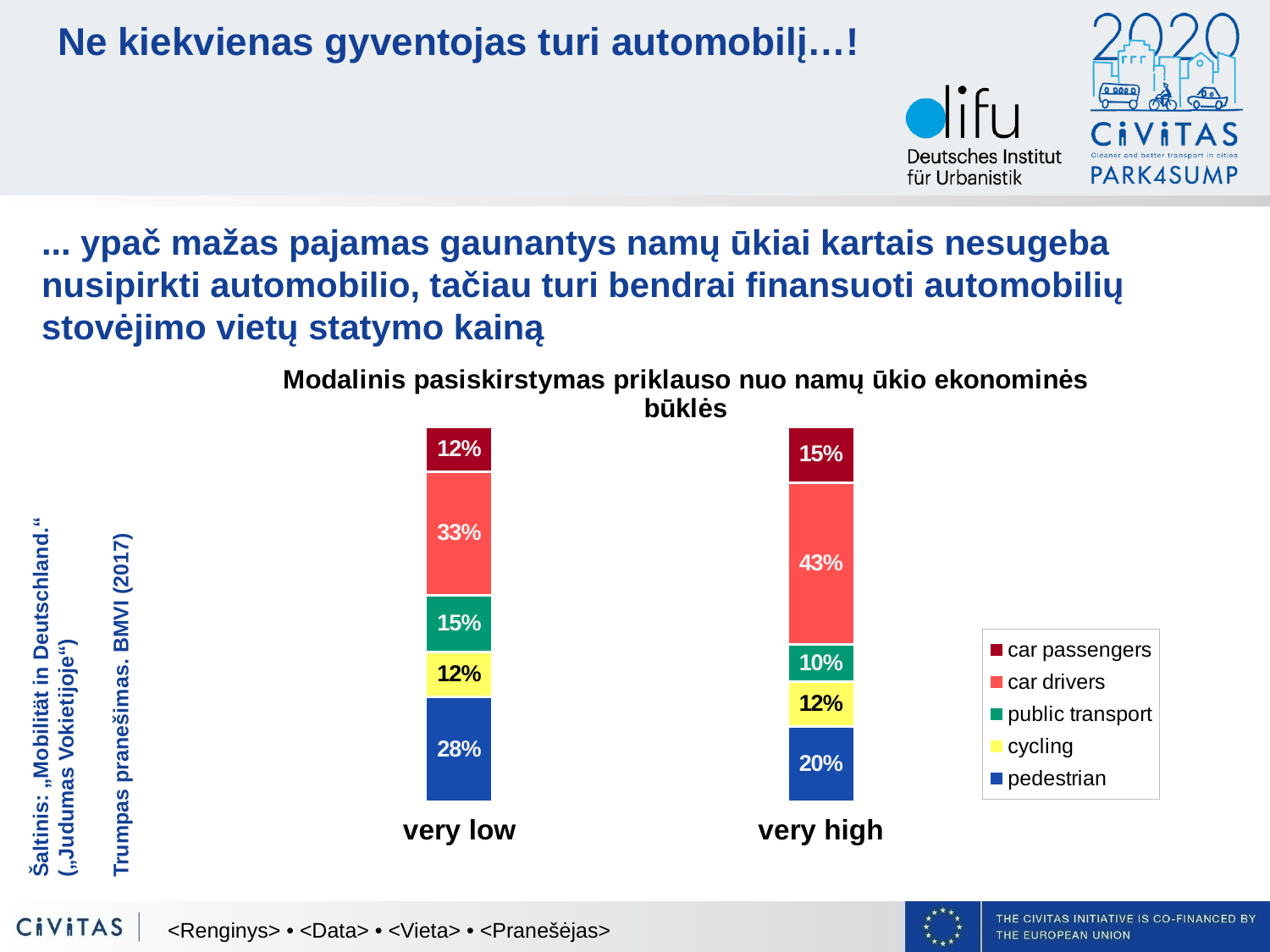
Which group has the larger pedestrian share, 'very low' or 'very high'? very low What is the total of the 'very low' stacked bar? 100% How many categories are shown on the x axis? 2 What is the public transport share for the 'very high' group? 10% What is the share of car drivers for the 'very low' household group? 33% What is the difference between the car drivers share for 'very high' and for 'very low'? 10% What type of chart is shown on the slide? stacked bar chart Which series has the largest share in the 'very high' bar? car drivers What is the car passengers share for the 'very high' group? 15% What is the share of car drivers for the 'very high' household group? 43% How many series does the legend list? 5 What is the pedestrian share for the 'very low' group? 28%